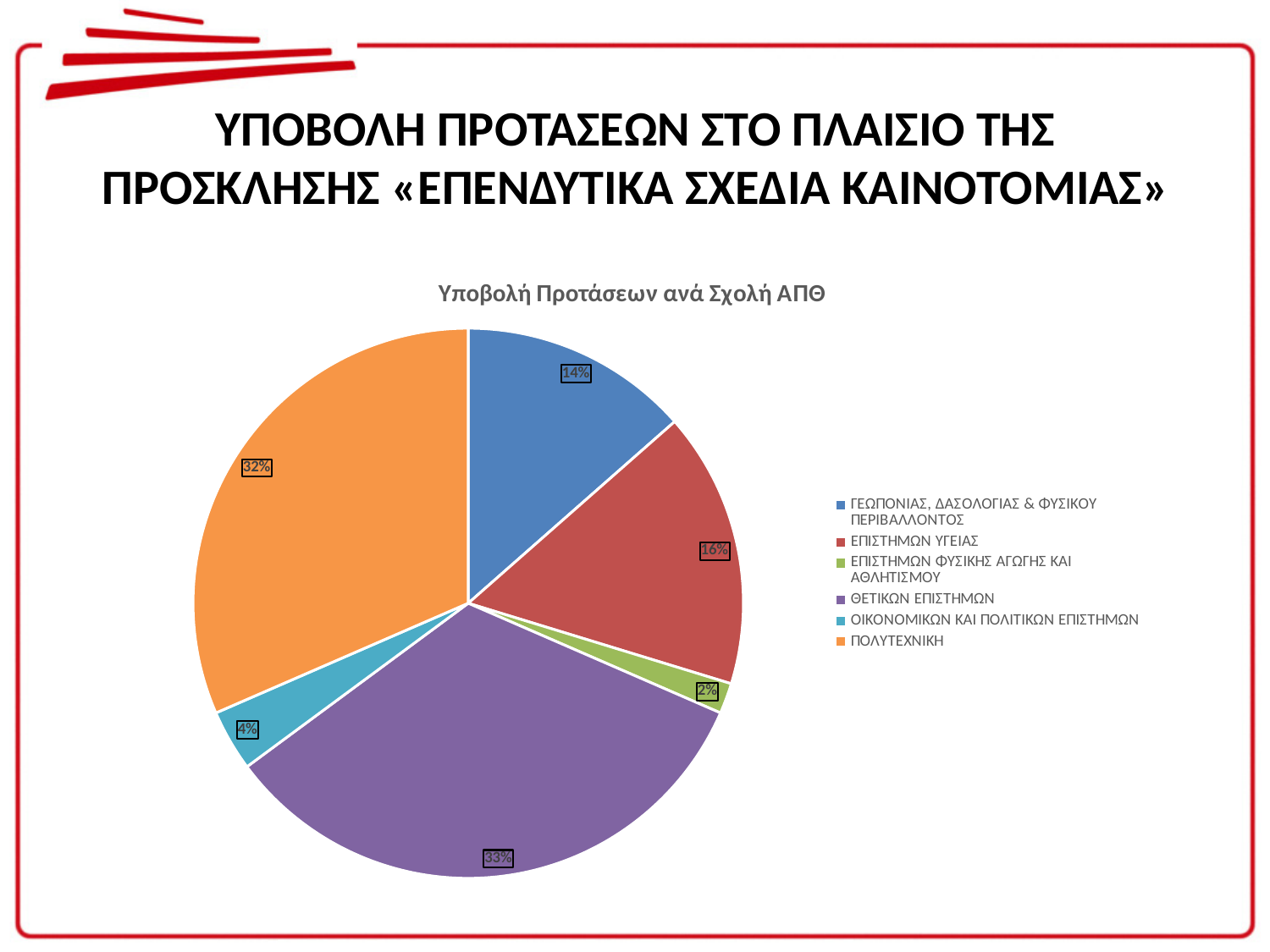
What percentage is shown for ΕΠΙΣΤΗΜΩΝ ΥΓΕΙΑΣ? 16% Which has a larger share, ΕΠΙΣΤΗΜΩΝ ΥΓΕΙΑΣ or ΓΕΩΠΟΝΙΑΣ, ΔΑΣΟΛΟΓΙΑΣ & ΦΥΣΙΚΟΥ ΠΕΡΙΒΑΛΛΟΝΤΟΣ? ΕΠΙΣΤΗΜΩΝ ΥΓΕΙΑΣ What colour is the slice for ΠΟΛΥΤΕΧΝΙΚΗ? Orange What is the difference in percentage points between ΕΠΙΣΤΗΜΩΝ ΥΓΕΙΑΣ and ΟΙΚΟΝΟΜΙΚΩΝ ΚΑΙ ΠΟΛΙΤΙΚΩΝ ΕΠΙΣΤΗΜΩΝ? 12% What share of the pie does ΠΟΛΥΤΕΧΝΙΚΗ have? 32% Which school has the largest slice of the pie? ΘΕΤΙΚΩΝ ΕΠΙΣΤΗΜΩΝ Which school has the smallest slice of the pie? ΕΠΙΣΤΗΜΩΝ ΦΥΣΙΚΗΣ ΑΓΩΓΗΣ ΚΑΙ ΑΘΛΗΤΙΣΜΟΥ How many schools (slices) are shown in the pie chart? 6 What is the title of the chart? Υποβολή Προτάσεων ανά Σχολή ΑΠΘ What percentage is shown for ΓΕΩΠΟΝΙΑΣ, ΔΑΣΟΛΟΓΙΑΣ & ΦΥΣΙΚΟΥ ΠΕΡΙΒΑΛΛΟΝΤΟΣ? 14% What share of the pie does ΘΕΤΙΚΩΝ ΕΠΙΣΤΗΜΩΝ have? 33% What type of chart is shown on the slide? Pie chart